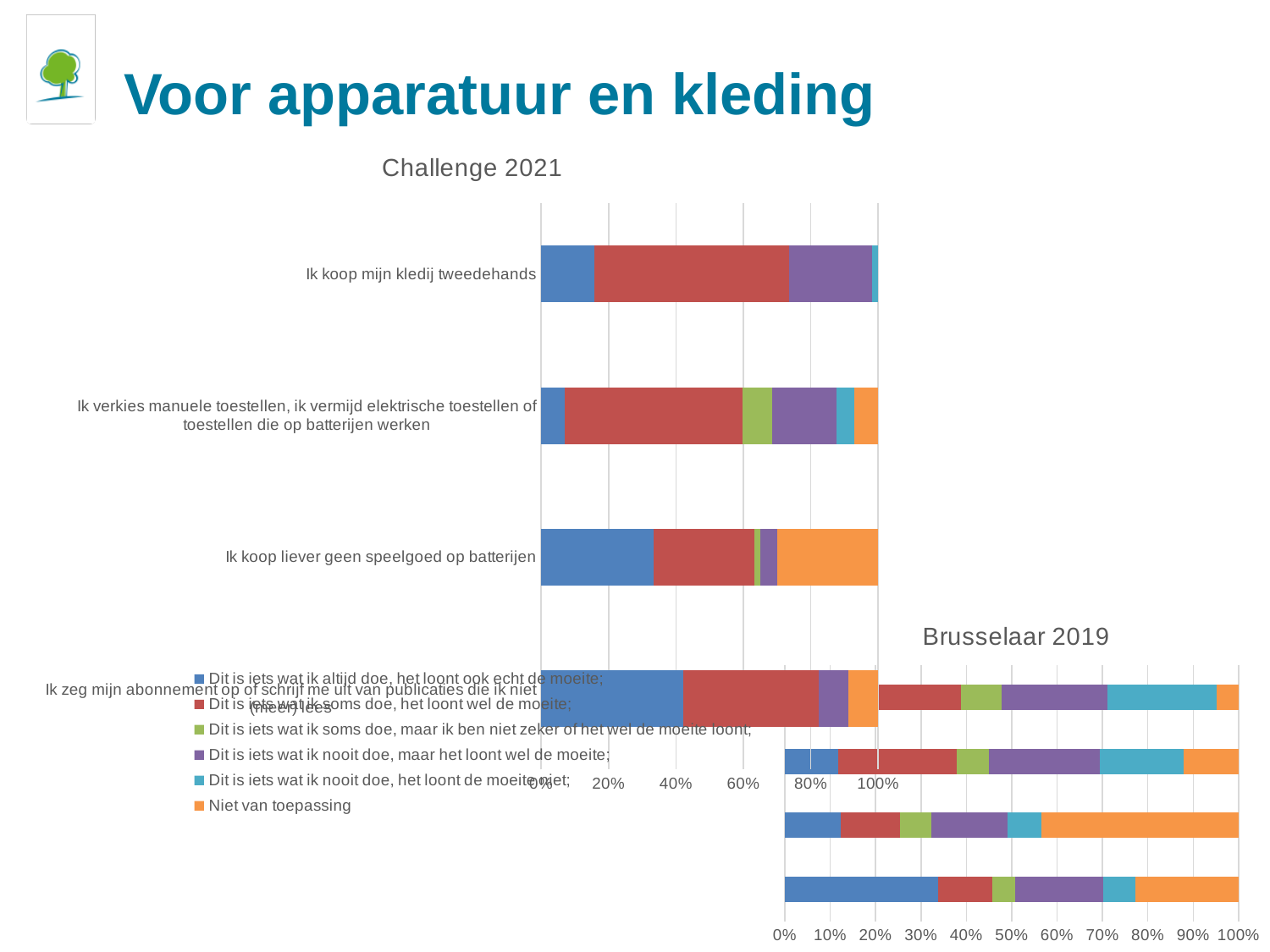
In the Brusselaar 2019 chart, is the orange 'Niet van toepassing' segment of the third bar from the top greater or less than 40%? greater What kind of chart is the Challenge 2021 chart? Stacked bar chart In the Challenge 2021 chart, is the red 'soms doe, het loont wel de moeite' segment larger for 'Ik koop mijn kledij tweedehands' or for 'Ik koop liever geen speelgoed op batterijen'? Ik koop mijn kledij tweedehands In the Challenge 2021 chart, is the blue 'Dit is iets wat ik altijd doe' share for 'Ik koop liever geen speelgoed op batterijen' greater or less than 20%? greater In the Challenge 2021 chart, is the orange 'Niet van toepassing' share for 'Ik koop liever geen speelgoed op batterijen' greater or less than 20%? greater What is the title of the chart on the right of the slide? Brusselaar 2019 In the Challenge 2021 chart, which category has the largest orange 'Niet van toepassing' segment? Ik koop liever geen speelgoed op batterijen How many bars are shown on the Brusselaar 2019 chart? 4 How many series does the legend list? 6 In the Challenge 2021 chart, which category has the largest blue 'Dit is iets wat ik altijd doe' segment? Ik zeg mijn abonnement op of schrijf me uit van publicaties die ik niet (meer) lees How many categories are shown on the Challenge 2021 chart? 4